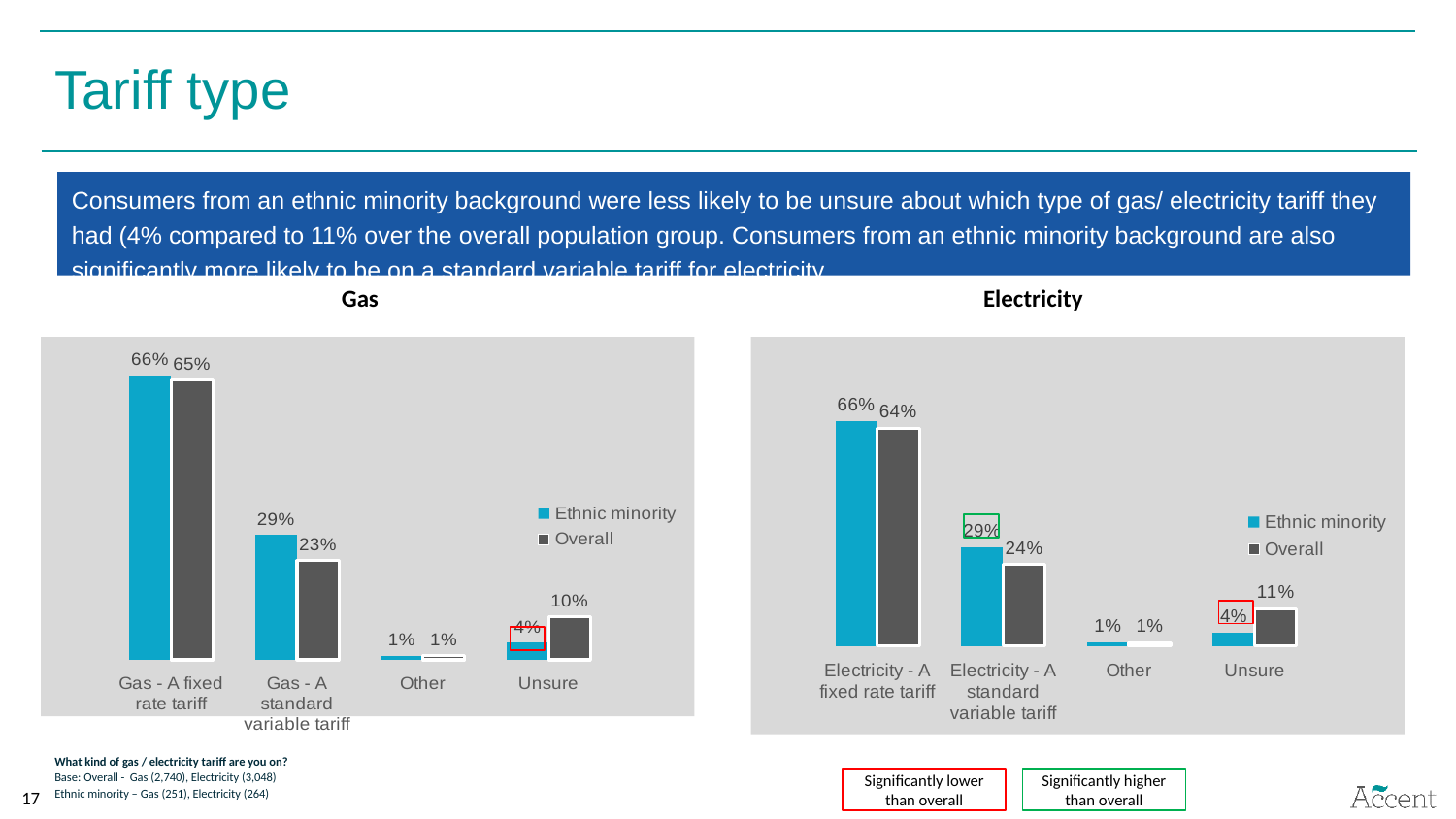
How many series does the legend of the Electricity chart list? 2 In the Gas chart, what is the Overall value for 'Unsure'? 10% In the Gas chart, what is the value for Ethnic minority on 'Gas - A standard variable tariff'? 29% In the Electricity chart, what is the Overall value for 'Electricity - A fixed rate tariff'? 64% What type of chart is the Gas chart? Bar chart How many categories are shown on the x axis of the Gas chart? 4 In the Electricity chart, which is larger for 'Electricity - A standard variable tariff': Ethnic minority or Overall? Ethnic minority In the Gas chart, which category has the highest value for the Overall series? Gas - A fixed rate tariff In the Gas chart, what is the difference between the Ethnic minority and Overall values for 'Gas - A standard variable tariff'? 6% In the Electricity chart, which category has the lowest value for the Ethnic minority series? Other In the Electricity chart, what is the difference between the Overall and Ethnic minority values for 'Unsure'? 7% In the Electricity chart, what is the Ethnic minority value for 'Unsure'? 4%